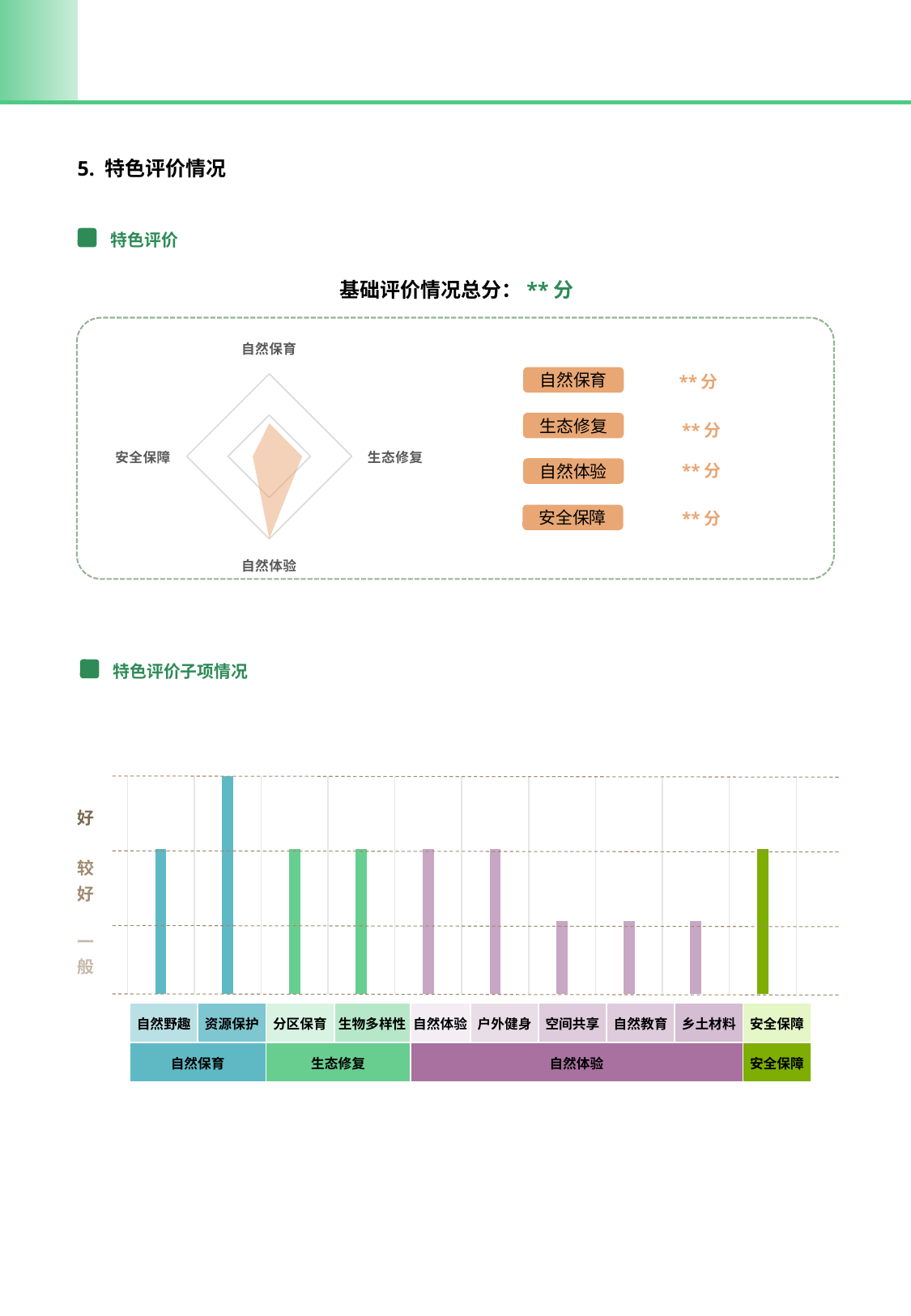
In the radar chart in the 特色评价 section, toward which axis does the shaded area extend furthest? 自然体验 What kind of chart is the chart titled 特色评价子项情况? bar chart What kind of chart is shown in the 特色评价 section at the top of the slide? radar chart In the 特色评价子项情况 bar chart, which category has the highest bar? 资源保护 In the 特色评价子项情况 bar chart, how many bars are plotted? 10 In the 特色评价子项情况 bar chart, which bar is taller: 资源保护 or 空间共享? 资源保护 In the 特色评价子项情况 bar chart, which rating level does the 安全保障 bar reach? 较好 In the radar chart in the 特色评价 section, how many axes (categories) are there? 4 In the 特色评价子项情况 bar chart, how many top-level groups are the categories divided into along the x axis? 4 In the 特色评价子项情况 bar chart, which rating level does the 空间共享 bar reach? 一般 In the 特色评价子项情况 bar chart, which bar is taller: 自然野趣 or 乡土材料? 自然野趣 In the 特色评价子项情况 bar chart, which rating level does the 资源保护 bar reach? 好